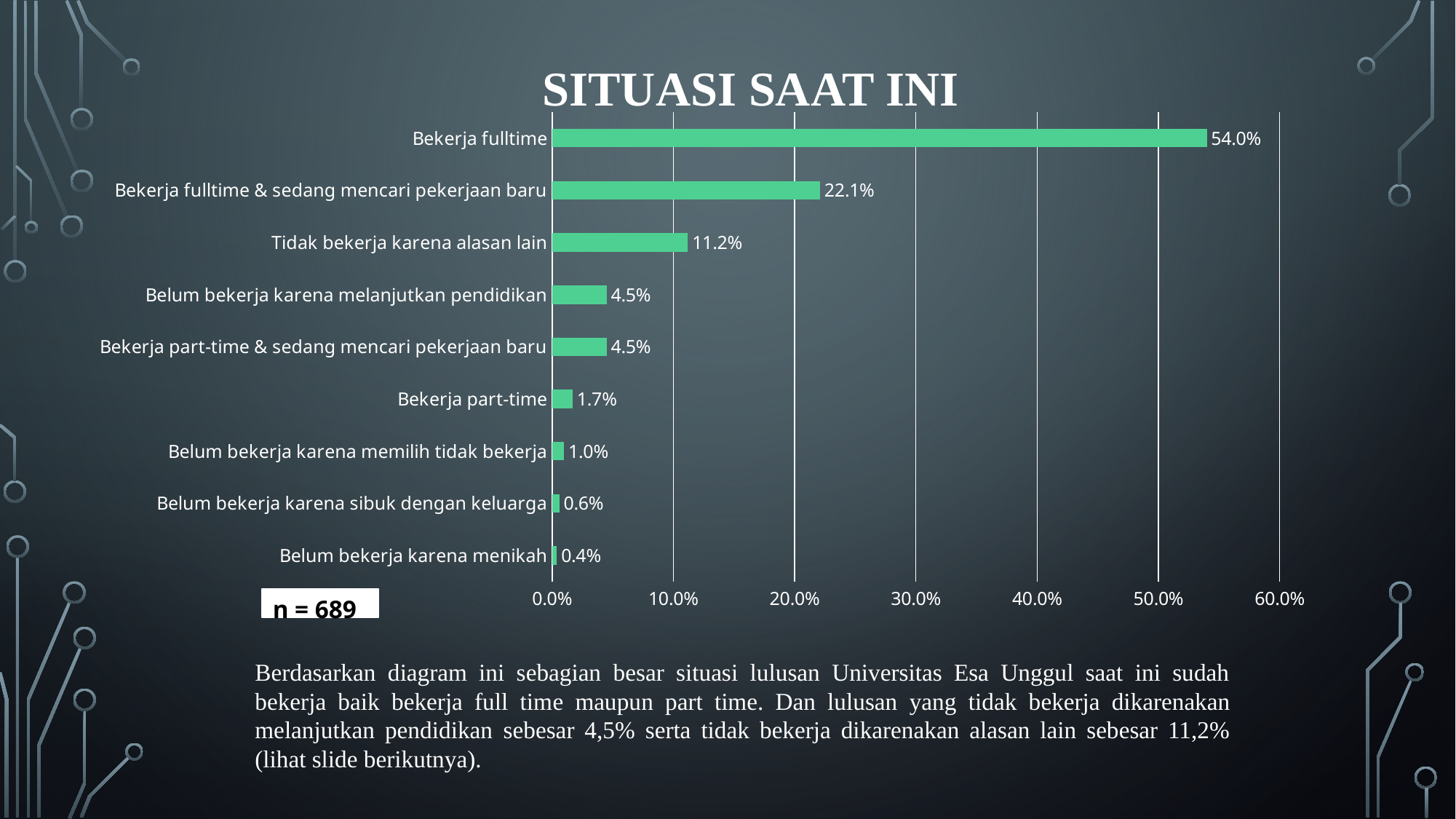
How many categories are shown in the chart? 9 Which category has the highest value? Bekerja fulltime Is the value for Bekerja fulltime greater or less than 50.0%? greater What is the value for Tidak bekerja karena alasan lain? 11.2% Which is larger, the value for Bekerja part-time or the value for Belum bekerja karena memilih tidak bekerja? Bekerja part-time What is the title of the chart? SITUASI SAAT INI What kind of chart is shown on the slide? bar chart What is the difference between the values for Bekerja fulltime and Bekerja fulltime & sedang mencari pekerjaan baru? 31.9% What is the value for Bekerja fulltime & sedang mencari pekerjaan baru? 22.1% What is the value for Bekerja fulltime? 54.0% What is the value for Belum bekerja karena menikah? 0.4% Which category has the lowest value? Belum bekerja karena menikah